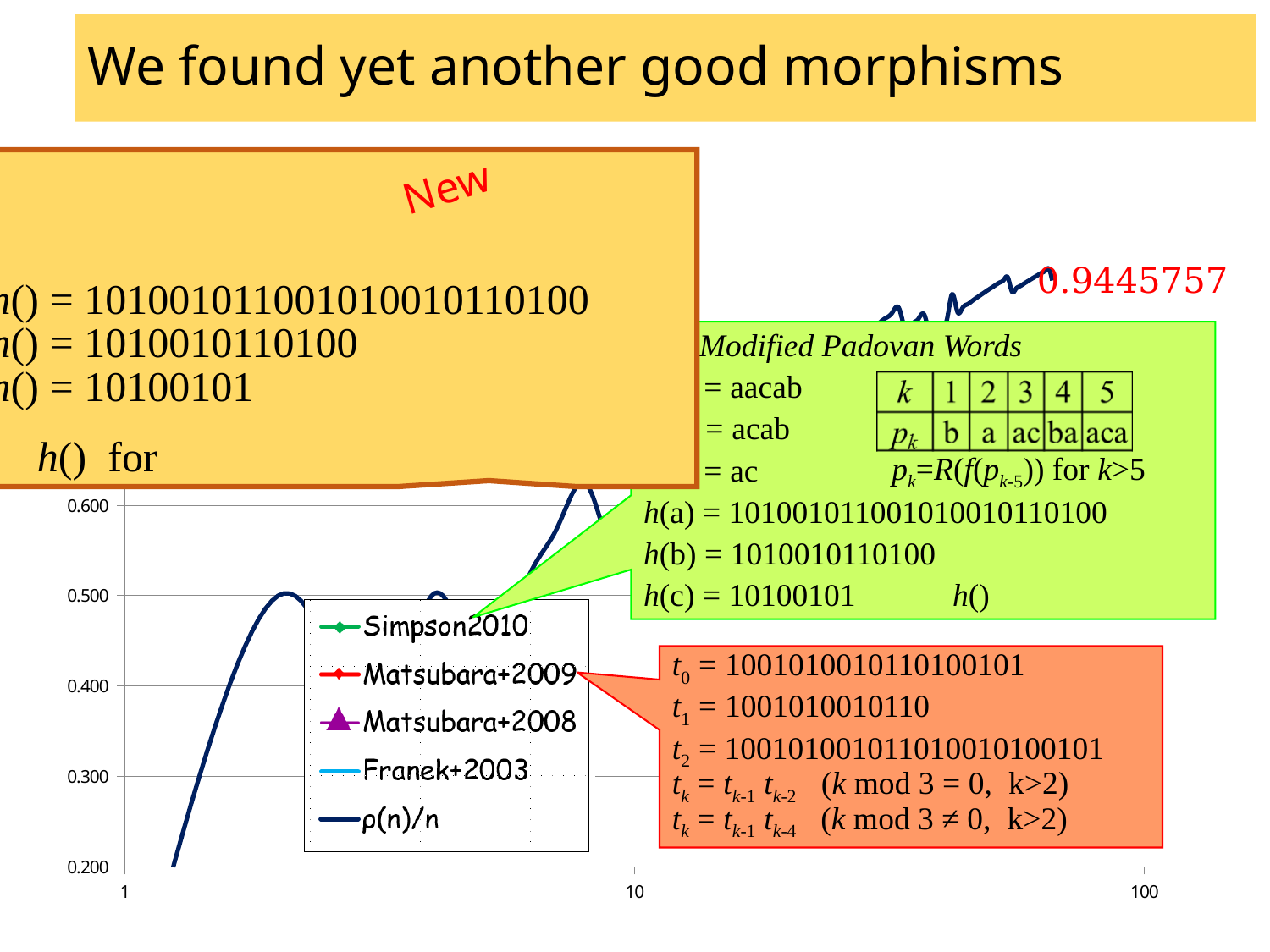
What is the largest tick value shown on the x axis? 100 Is the value of ρ(n)/n near n = 100 greater or less than 0.600? greater How many series does the chart's legend list? 5 What kind of chart is shown on the slide? line chart Which series in the legend is marked with purple triangles? Matsubara+2008 What value is printed as a label at the upper right end of the ρ(n)/n curve? 0.9445757 Does the ρ(n)/n curve overall rise or fall as n increases from 1 to 100? rise Is the value of ρ(n)/n at the left end of the curve (near n = 1) greater or less than 0.300? less How many tick labels are shown on the x axis? 3 What is the lowest tick value shown on the y axis? 0.200 Which series is drawn as a dark navy line in the chart? ρ(n)/n